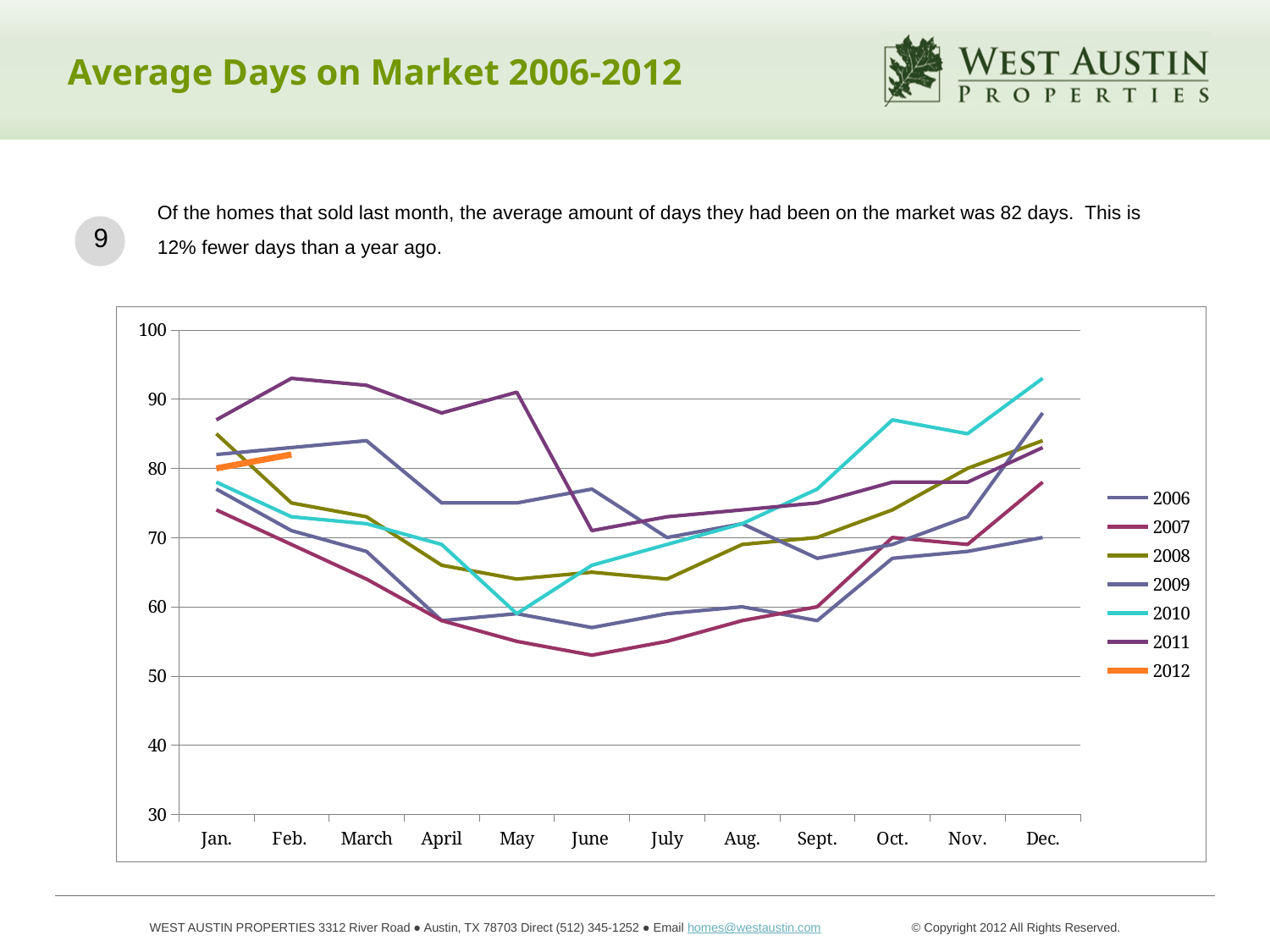
Is the value for 2011 in Feb. greater or less than 90? greater Does the 2007 line rise or fall from Jan. to June? fall Is the value for 2007 in June greater or less than 60? less Which year's line is shown in orange? 2012 What kind of chart is shown on the slide? line chart In April, which is larger: the value for 2011 or the value for 2007? 2011 How many series does the legend list? 7 Which year's line only has data for Jan. and Feb.? 2012 Is the value for 2010 in Dec. greater or less than 90? greater How many months are shown along the x axis? 12 Which year has the highest value in Feb.? 2011 Which year has the lowest value in June? 2007